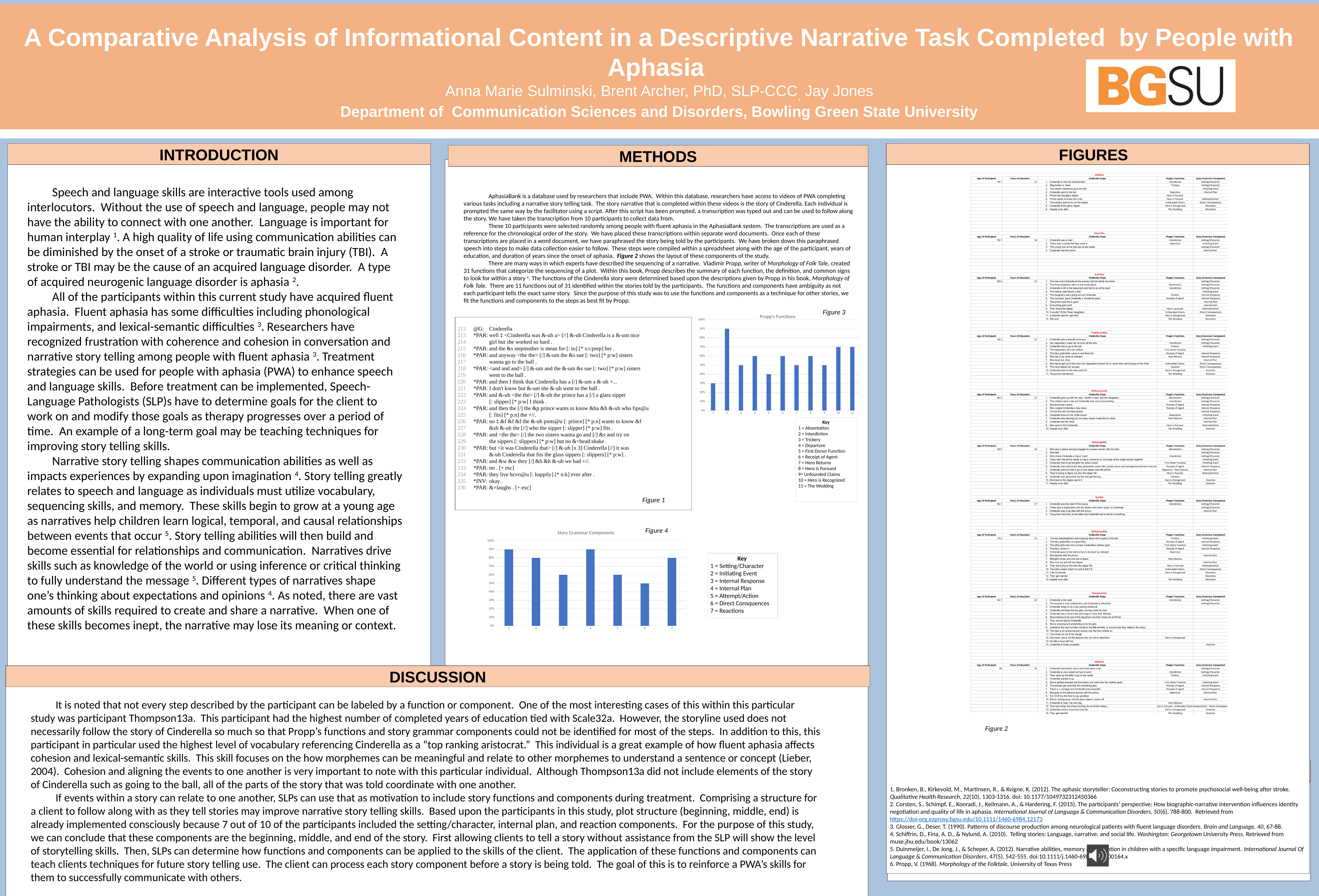
In the Story Grammar Components chart (Figure 4), which category has the lowest bar? 6 In the Propp's Functions chart (Figure 3), is the value for category 2 greater or less than 80%? greater How many categories are plotted on the x axis of the Propp's Functions chart (Figure 3)? 11 In the Story Grammar Components chart (Figure 4), is the value for category 1 greater or less than 80%? greater What kind of chart is the Propp's Functions chart (Figure 3)? bar chart In the Propp's Functions chart (Figure 3), which category has the lowest bar? 1 In the Propp's Functions chart (Figure 3), which is larger, the value for category 2 or the value for category 5? category 2 How many categories are plotted on the x axis of the Story Grammar Components chart (Figure 4)? 7 In the Propp's Functions chart (Figure 3), is the value for category 1 greater or less than 40%? less In the Propp's Functions chart (Figure 3), which category has the highest bar? 2 According to the key of the Propp's Functions chart (Figure 3), what does 11 stand for? The Wedding In the Story Grammar Components chart (Figure 4), which is larger, the value for category 4 or the value for category 6? category 4